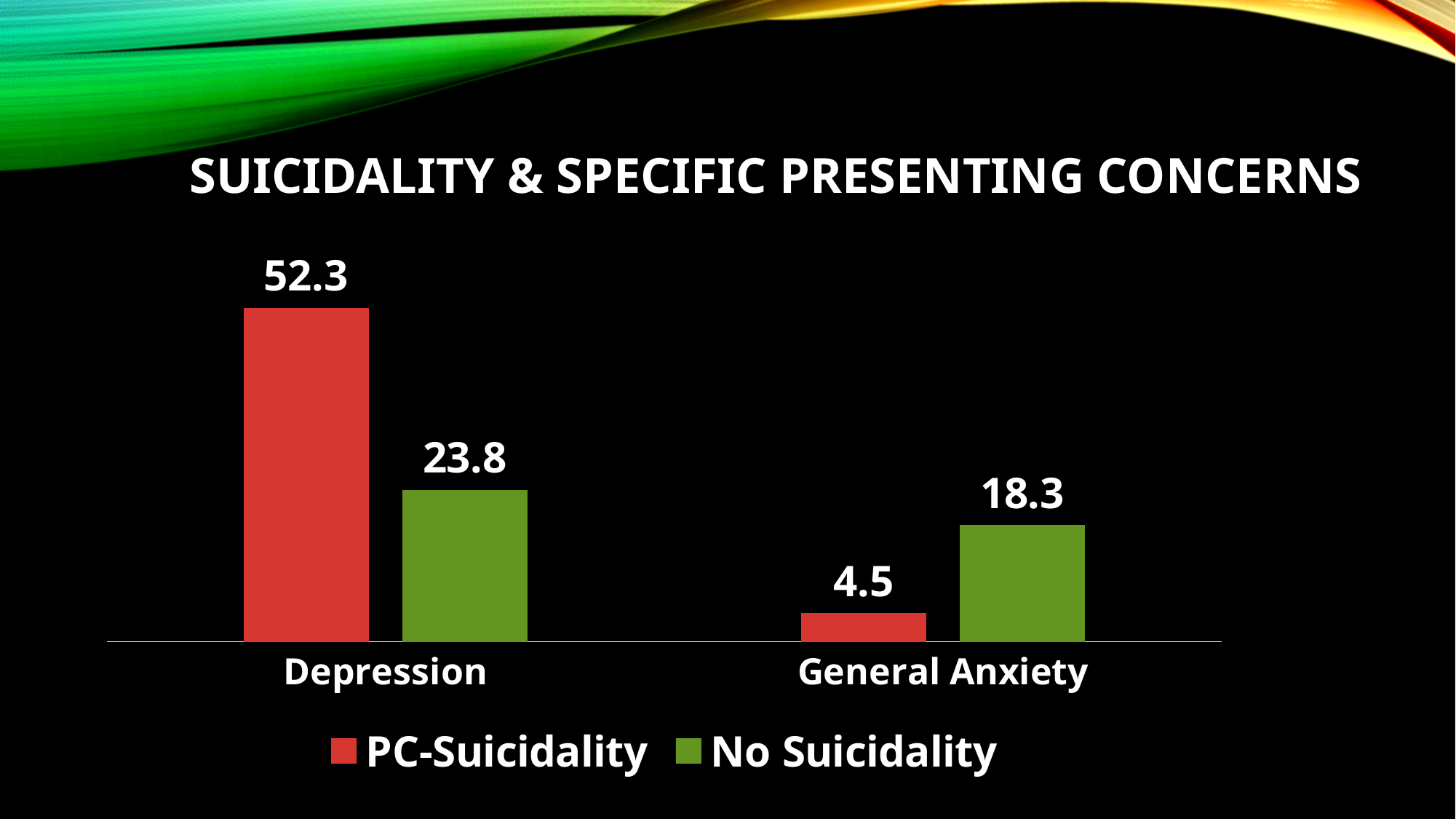
What is the difference between the PC-Suicidality and No Suicidality values for Depression? 28.5 How many series does the legend list? 2 How many categories are shown on the x axis? 2 What is the No Suicidality value for General Anxiety? 18.3 What type of chart is shown on the slide? Bar chart What is the difference between the No Suicidality and PC-Suicidality values for General Anxiety? 13.8 Which category has the highest PC-Suicidality value? Depression Which category has the lowest No Suicidality value? General Anxiety What is the PC-Suicidality value for Depression? 52.3 For General Anxiety, which series has the larger value, PC-Suicidality or No Suicidality? No Suicidality What is the PC-Suicidality value for General Anxiety? 4.5 What is the No Suicidality value for Depression? 23.8